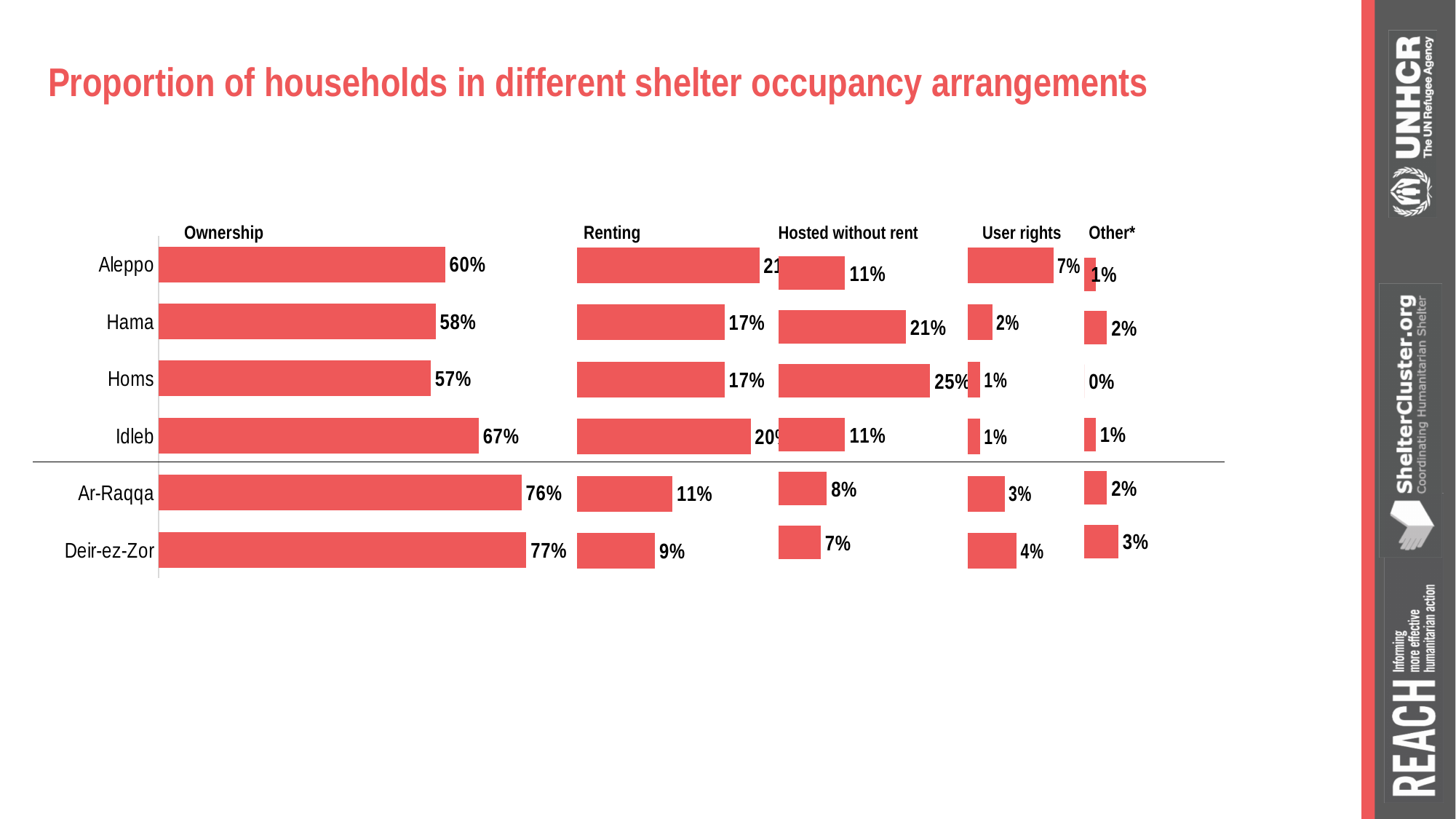
What is the User rights value for Aleppo? 7% What is the Other* value for Deir-ez-Zor? 3% How many governorates are shown in the chart? 6 What is the Ownership value for Deir-ez-Zor? 77% What type of chart is shown on the slide? Bar chart Which governorate has the lowest Renting value? Deir-ez-Zor What is the Hosted without rent value for Hama? 21% What is the difference between the Ownership values for Idleb and Aleppo? 7% Which is larger, the Hosted without rent value for Ar-Raqqa or for Deir-ez-Zor? Ar-Raqqa Which governorate has the lowest Ownership value? Homs What is the Renting value for Hama? 17% Which governorate has the highest Ownership value? Deir-ez-Zor